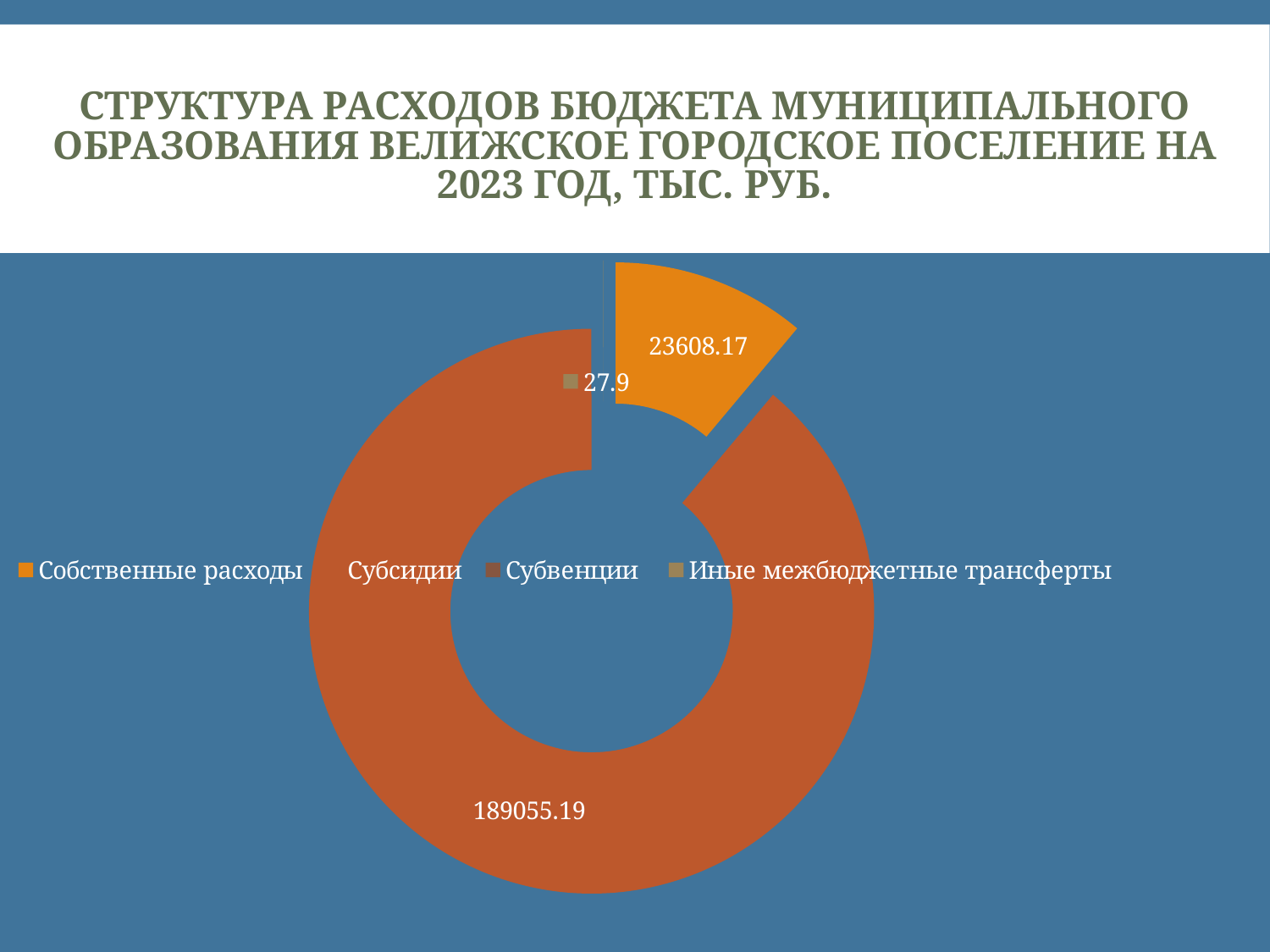
What value is shown for the Собственные расходы segment? 23608.17 What unit of measurement is stated in the slide title? тыс. руб. Which year does the chart title refer to? 2023 How many categories does the legend list? 4 What value is shown for the Иные межбюджетные трансферты segment? 27.9 What type of chart is shown on the slide? Doughnut (pie) chart Which labelled category has the smallest value in the chart? Иные межбюджетные трансферты Which category has the largest value in the chart? Субсидии How many data labels are printed on the chart? 3